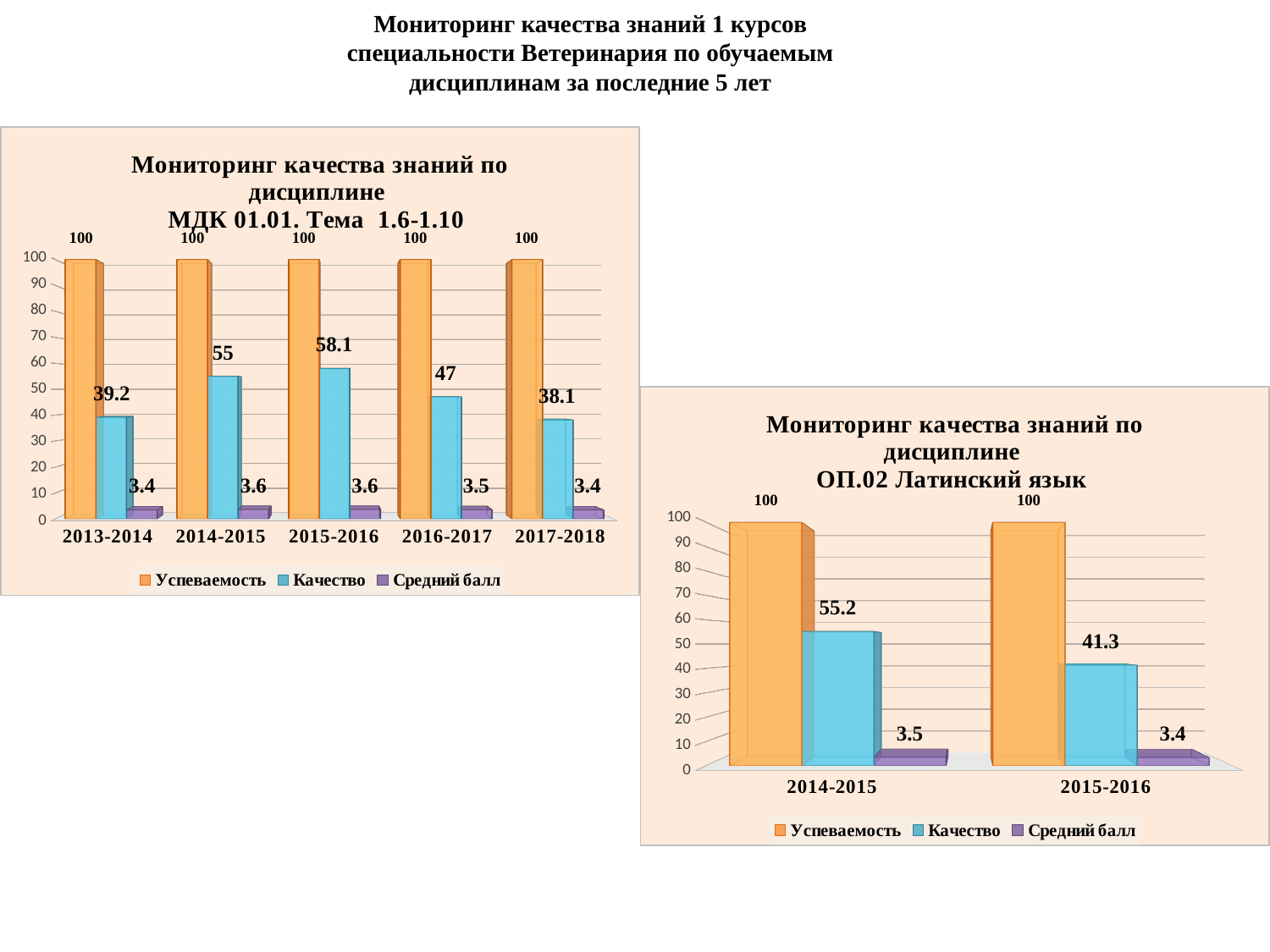
In the chart titled 'МДК 01.01. Тема 1.6-1.10', what is the difference between the Качество values for 2015-2016 and 2013-2014? 18.9 What type of chart is the chart titled 'ОП.02 Латинский язык'? bar chart In the chart titled 'МДК 01.01. Тема 1.6-1.10', what is the Средний балл value for 2016-2017? 3.5 In the chart titled 'МДК 01.01. Тема 1.6-1.10', which year has the highest Качество value? 2015-2016 In the chart titled 'ОП.02 Латинский язык', which year has the larger Качество value, 2014-2015 or 2015-2016? 2014-2015 In the chart titled 'ОП.02 Латинский язык', how many series does the legend list? 3 In the chart titled 'МДК 01.01. Тема 1.6-1.10', does the Качество value rise or fall from 2015-2016 to 2017-2018? fall In the chart titled 'МДК 01.01. Тема 1.6-1.10', what is the value of Качество for 2014-2015? 55 In the chart titled 'ОП.02 Латинский язык', what is the difference between the Качество values for 2014-2015 and 2015-2016? 13.9 In the chart titled 'МДК 01.01. Тема 1.6-1.10', how many year categories are shown on the x axis? 5 In the chart titled 'МДК 01.01. Тема 1.6-1.10', which year has the lowest Качество value? 2017-2018 In the chart titled 'ОП.02 Латинский язык', what is the Качество value for 2015-2016? 41.3